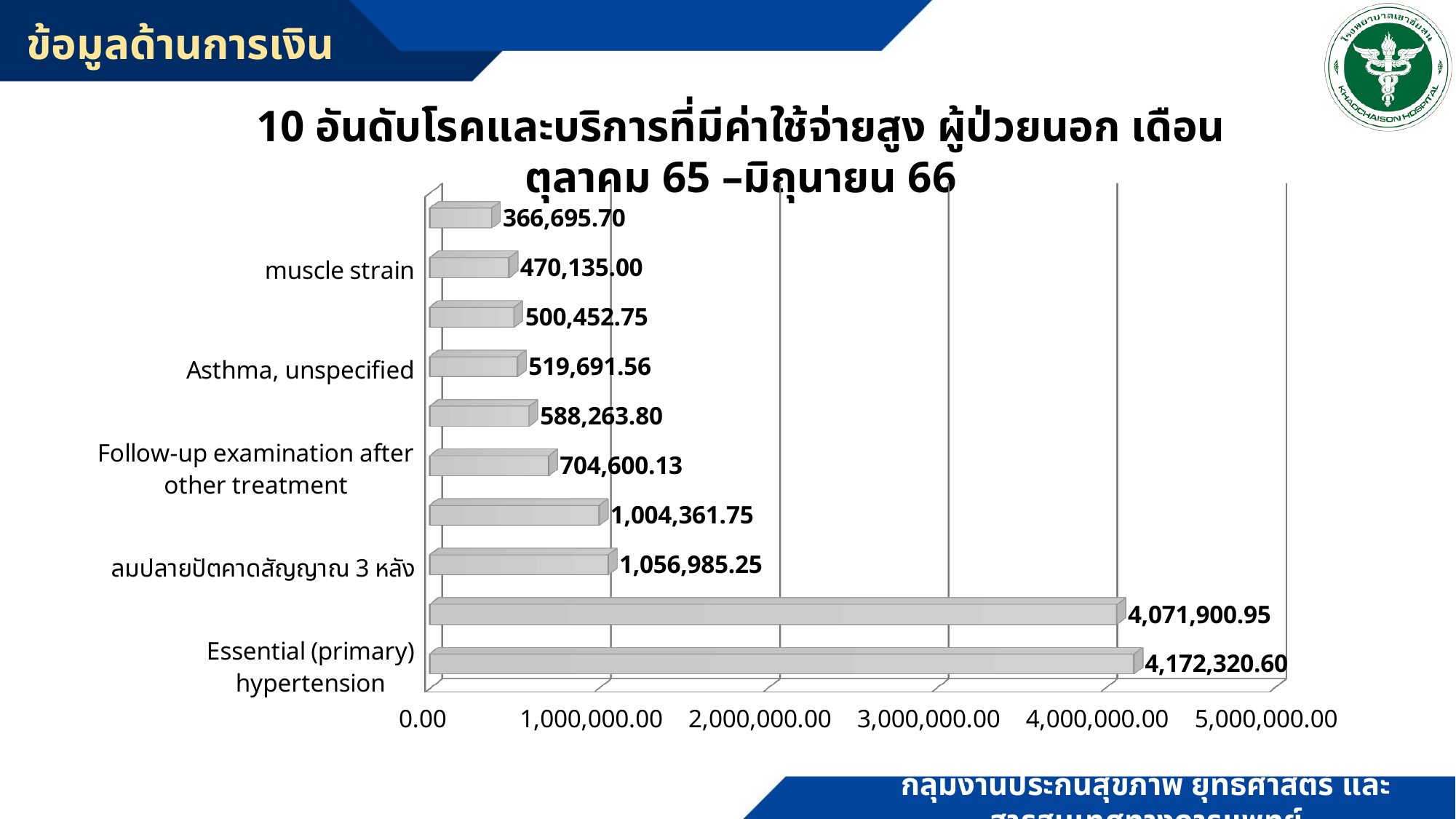
Which is larger, the value for Asthma, unspecified or the value for muscle strain? Asthma, unspecified Which category has the highest value? Essential (primary) hypertension What is the value for Asthma, unspecified? 519,691.56 What is the value for Essential (primary) hypertension? 4,172,320.60 What is the value for Follow-up examination after other treatment? 704,600.13 What is the difference between the values for Essential (primary) hypertension and ลมปลายปัตคาดสัญญาณ 3 หลัง? 3,115,335.35 What is the value for muscle strain? 470,135.00 What is the value for ลมปลายปัตคาดสัญญาณ 3 หลัง? 1,056,985.25 What is the difference between the values for Follow-up examination after other treatment and muscle strain? 234,465.13 How many bars are plotted in the chart? 10 Is the value for Essential (primary) hypertension greater or less than 4,000,000.00? greater What kind of chart is shown on the slide? bar chart